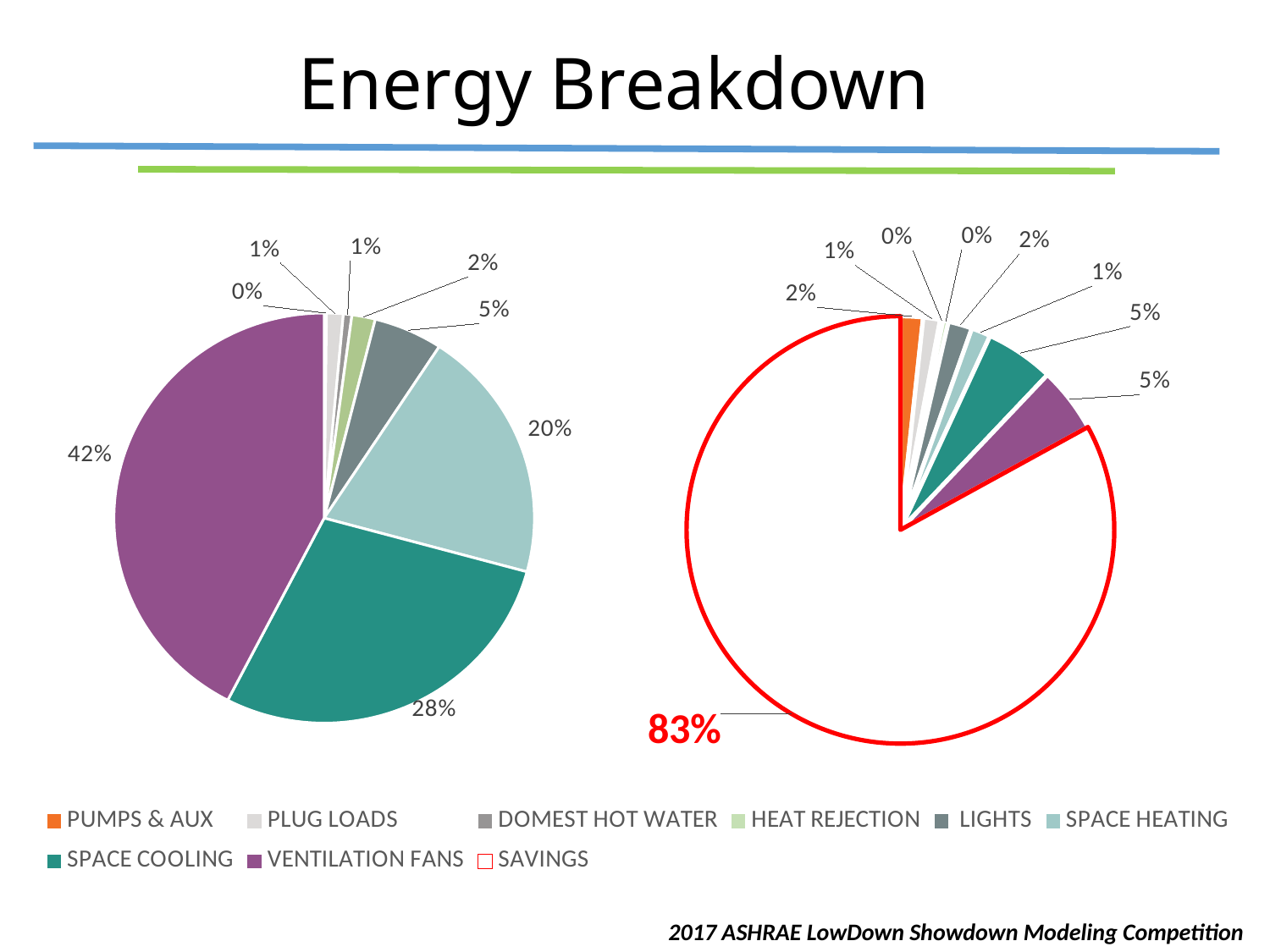
How many entries does the legend list? 9 What is the title of the slide? Energy Breakdown In the left pie chart, which is larger, SPACE COOLING or SPACE HEATING? SPACE COOLING In the left pie chart, what share does SPACE HEATING have? 20% In the right pie chart, what share does SAVINGS have? 83% In the left pie chart, which category has the largest slice? VENTILATION FANS In the left pie chart, what share does VENTILATION FANS have? 42% What kind of charts are shown on the slide? Pie charts In the right pie chart, which category has the largest slice? SAVINGS In the left pie chart, what is the difference in percentage points between VENTILATION FANS and SPACE COOLING? 14 percentage points